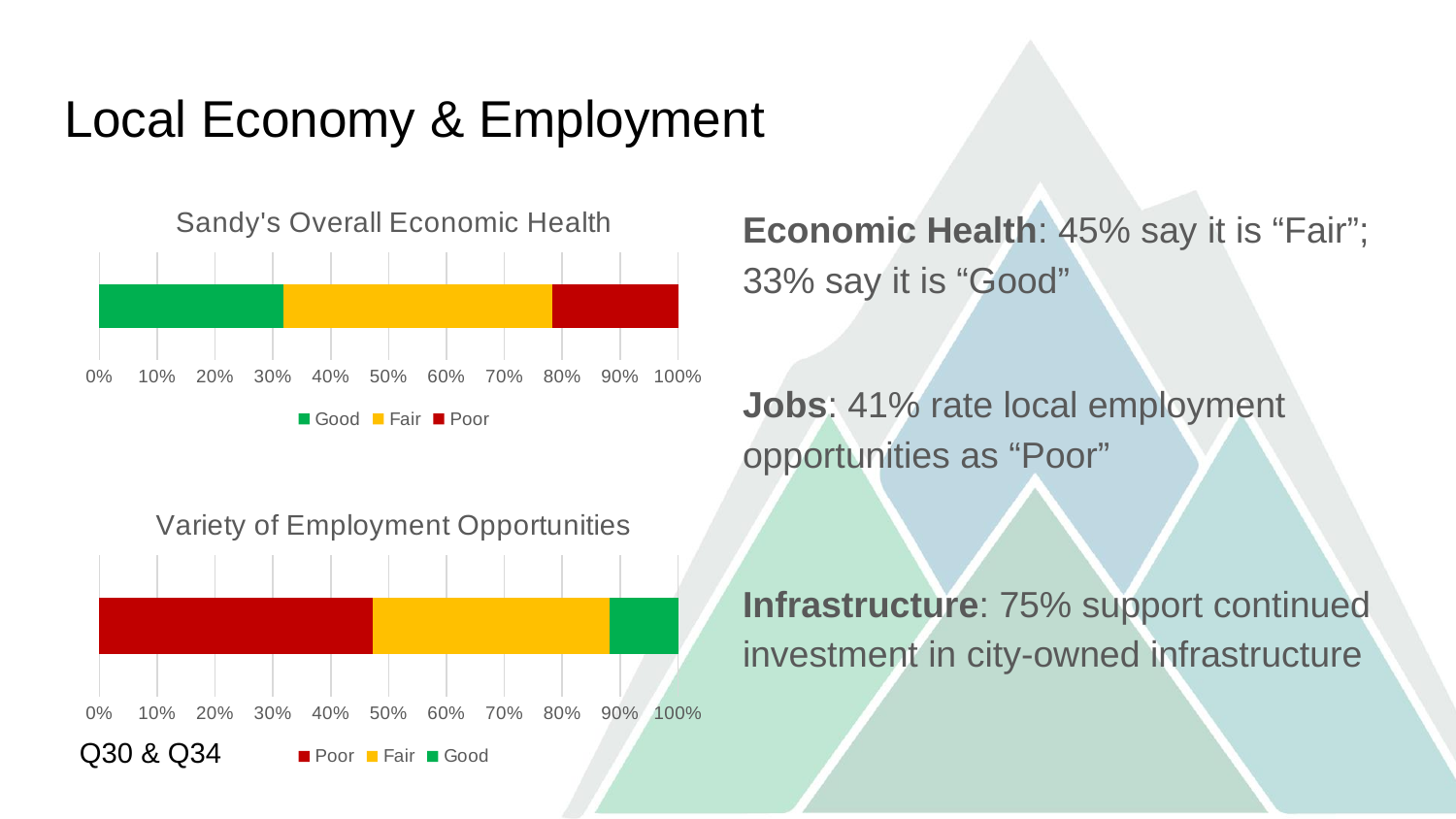
How many series does the legend of the "Variety of Employment Opportunities" chart list? 3 In the "Variety of Employment Opportunities" chart, is the Good segment greater or less than 20%? less In the "Sandy's Overall Economic Health" chart, which rating has the largest segment? Fair In the "Sandy's Overall Economic Health" chart, which is larger, the Fair segment or the Good segment? Fair In the "Variety of Employment Opportunities" chart, is the Poor segment greater or less than 40%? greater In the "Variety of Employment Opportunities" chart, which is larger, the Poor segment or the Good segment? Poor In the "Sandy's Overall Economic Health" chart, which rating has the smallest segment? Poor What colour represents "Fair" in both charts? Yellow In the "Sandy's Overall Economic Health" chart, is the Fair segment greater or less than 40%? greater What kind of chart is "Sandy's Overall Economic Health"? Stacked bar chart In the "Variety of Employment Opportunities" chart, which rating has the smallest segment? Good